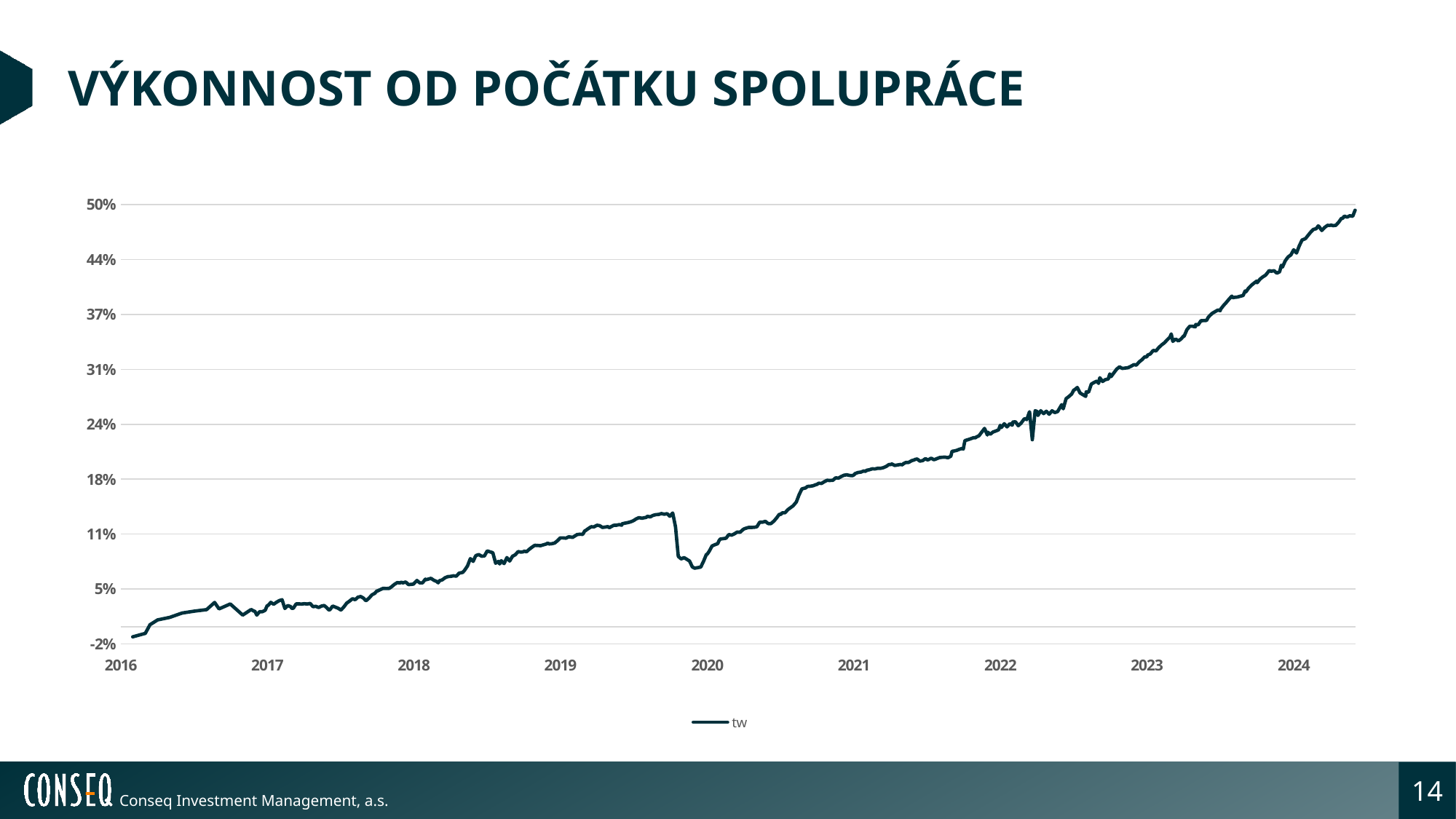
In which year does the tw line have its lowest value? 2016 What is the name of the series shown in the legend? tw In which year does the tw line reach its highest value? 2024 Is the value of tw at the start of 2020 greater or less than 11%? less How many series does the legend list? 1 Is the value of tw at the start of 2023 greater or less than 24%? greater What kind of chart is shown on the slide? line chart Overall, does the tw line rise or fall from 2016 to 2024? rise How many year labels are shown on the x axis? 9 Is the final value of tw at the right end of the line greater or less than 44%? greater What is the title of the slide containing the chart? VÝKONNOST OD POČÁTKU SPOLUPRÁCE